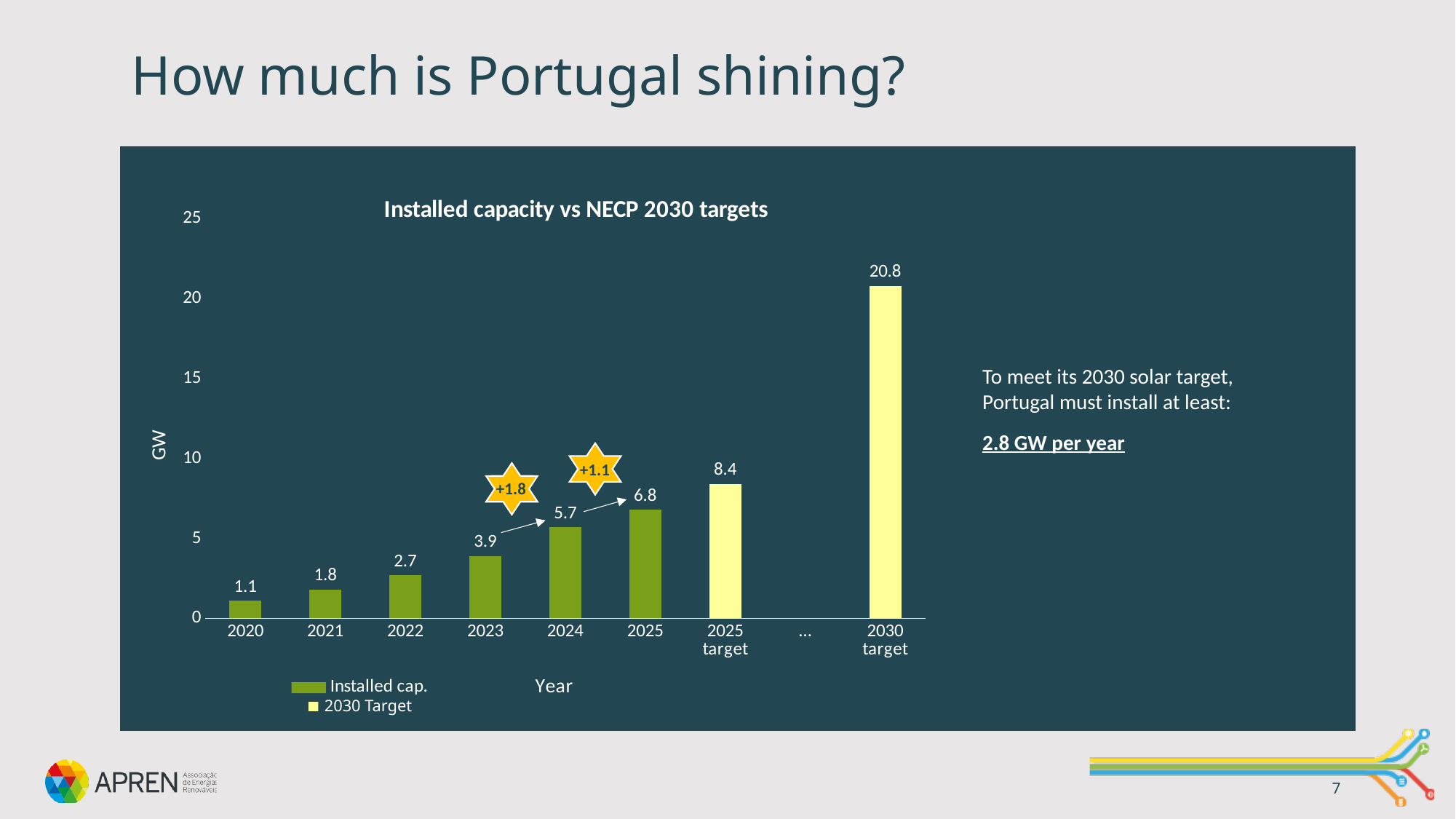
What is the difference between the 2025 target and the installed capacity in 2025? 1.6 What is the value of the 2030 target bar? 20.8 What kind of chart is shown on the slide? bar chart Which category has the lowest value in the chart? 2020 How many series does the legend list? 2 What is the difference between installed capacity in 2024 and 2023? 1.8 What is the value of the 2025 target bar? 8.4 What is the installed capacity for 2022? 2.7 Is the value for the 2030 target greater or less than 20? greater Does installed capacity rise or fall from 2020 to 2025? rise Which is larger, the installed capacity in 2021 or in 2023? 2023 Which category has the highest value in the chart? 2030 target